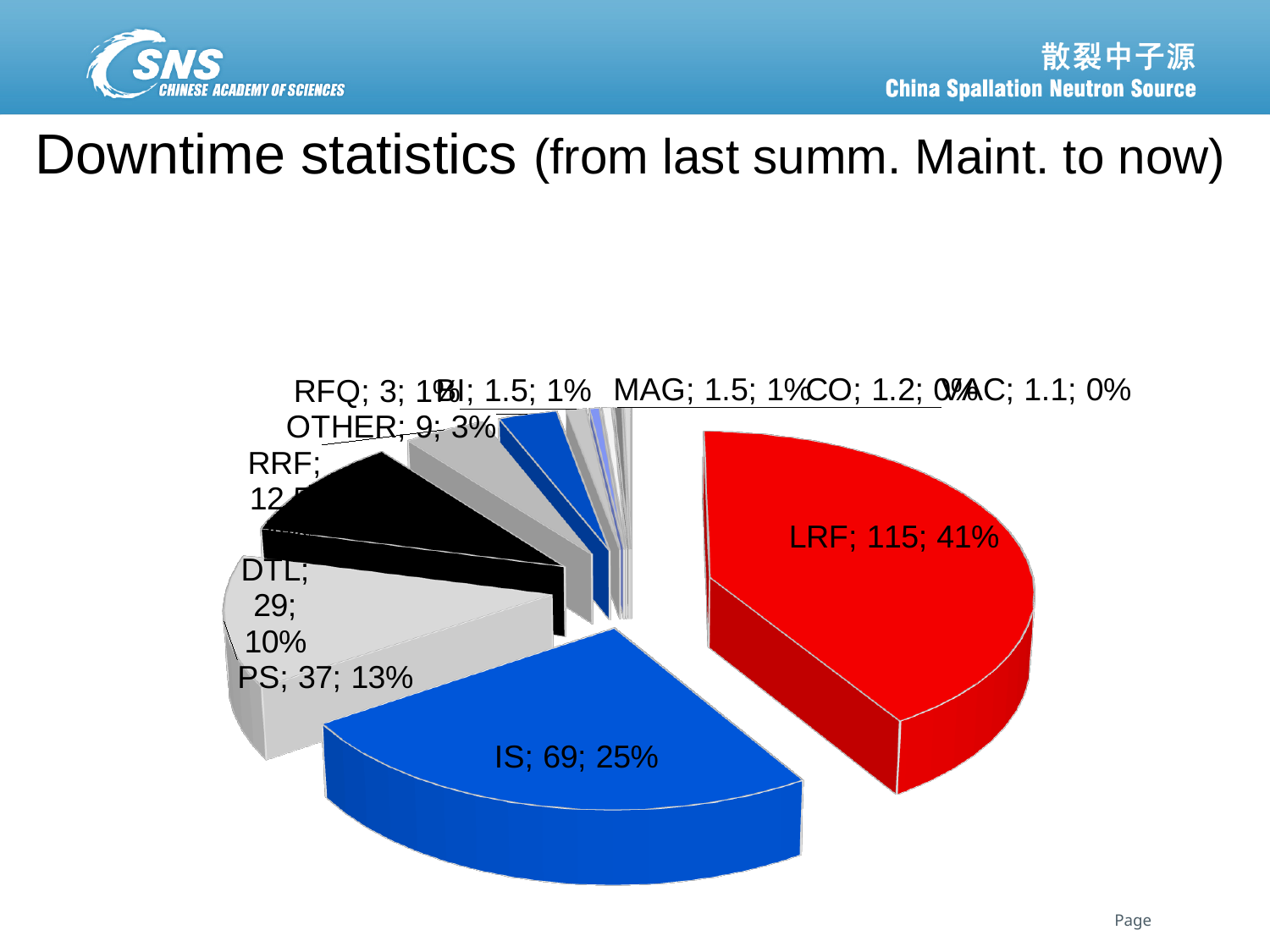
What is the downtime value for DTL? 29 What type of chart is shown on the slide? Pie chart Which category has the largest slice of the pie? LRF What share of the pie does LRF account for? 41% Which category has the smallest value in the pie? VAC Which has the larger value, PS or DTL? PS What is the downtime value for OTHER? 9 What is the difference between the LRF value and the IS value? 46 What is the downtime value for LRF? 115 What share of the pie does IS account for? 25% What is the downtime value for PS? 37 What is the downtime value for IS? 69